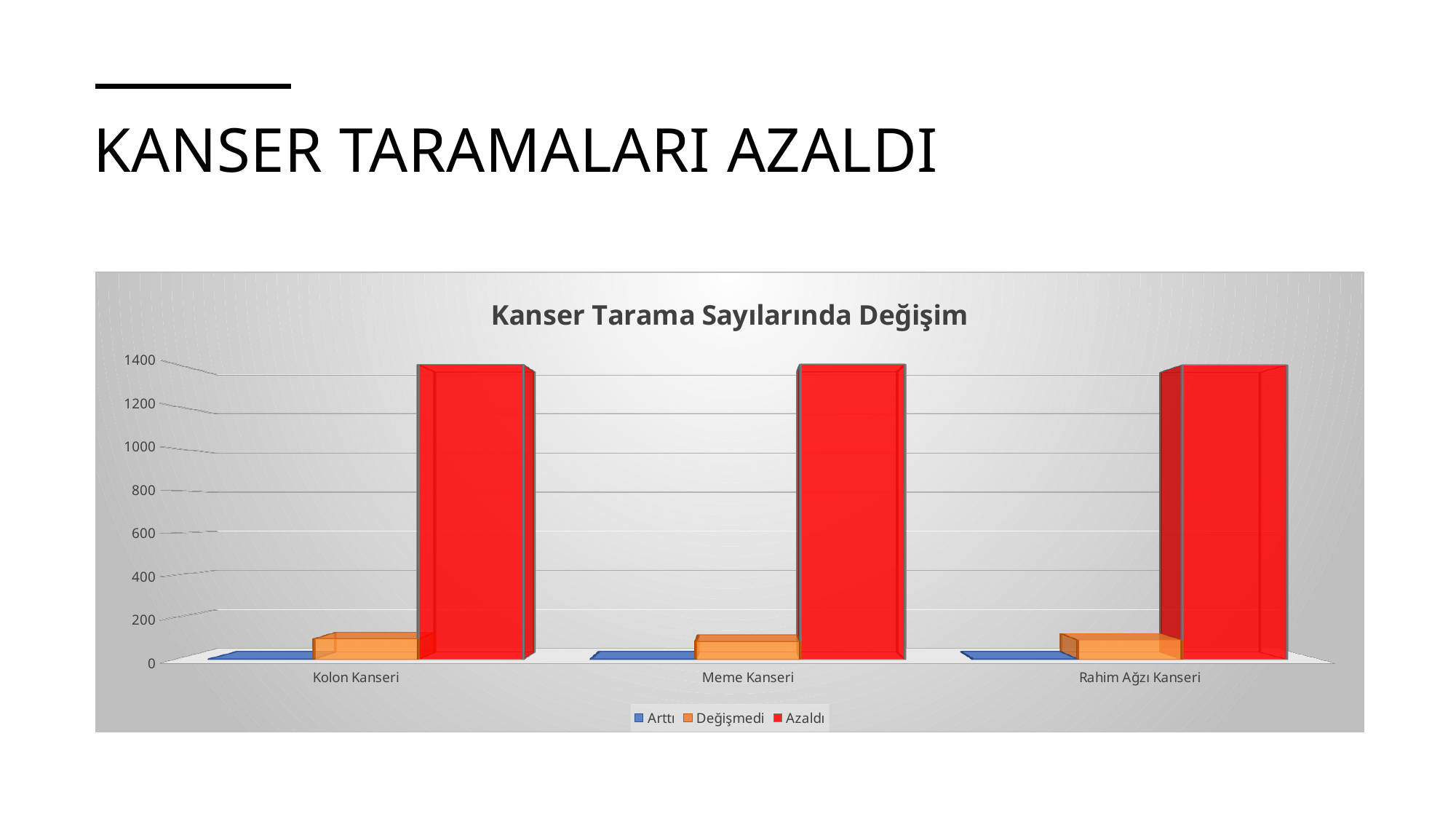
Is the Değişmedi value for Meme Kanseri greater or less than 200? less Is the Azaldı value for Kolon Kanseri greater or less than 1000? greater Which series has the highest value for Kolon Kanseri? Azaldı How many series does the legend list? 3 Which colour represents the Azaldı series in the legend? Red What is the title of the chart? Kanser Tarama Sayılarında Değişim How many categories are shown on the x axis? 3 Which series has the lowest value for Meme Kanseri? Arttı For Rahim Ağzı Kanseri, which is larger: the Azaldı value or the Değişmedi value? Azaldı What type of chart is shown on the slide? Bar chart Is the Azaldı value for Meme Kanseri greater or less than 1200? greater